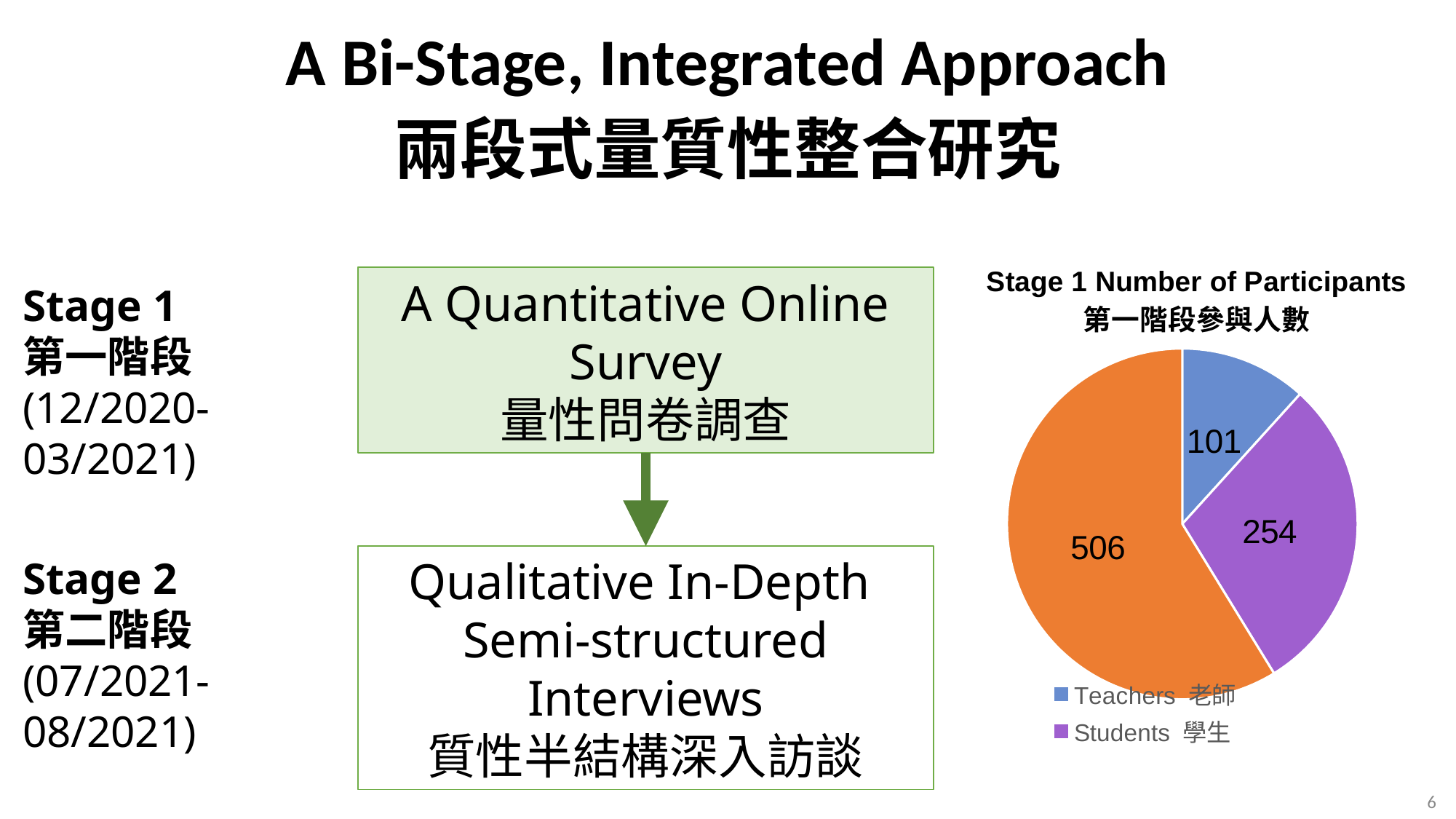
How many entries does the chart legend list? 2 What is the title of the chart? Stage 1 Number of Participants 第一階段參與人數 What type of chart is shown on the slide? pie chart Which group has more participants, Teachers or Students? Students How many participants are Teachers (老師) in the pie chart? 101 What is the value shown on the largest slice of the pie chart? 506 How many slices does the pie chart have? 3 What is the difference between the number of Students and the number of Teachers? 153 What is the difference between the largest slice value and the Students value? 252 What is the value shown on the smallest slice of the pie chart? 101 What is the total of all the values shown on the pie chart? 861 How many participants are Students (學生) in the pie chart? 254